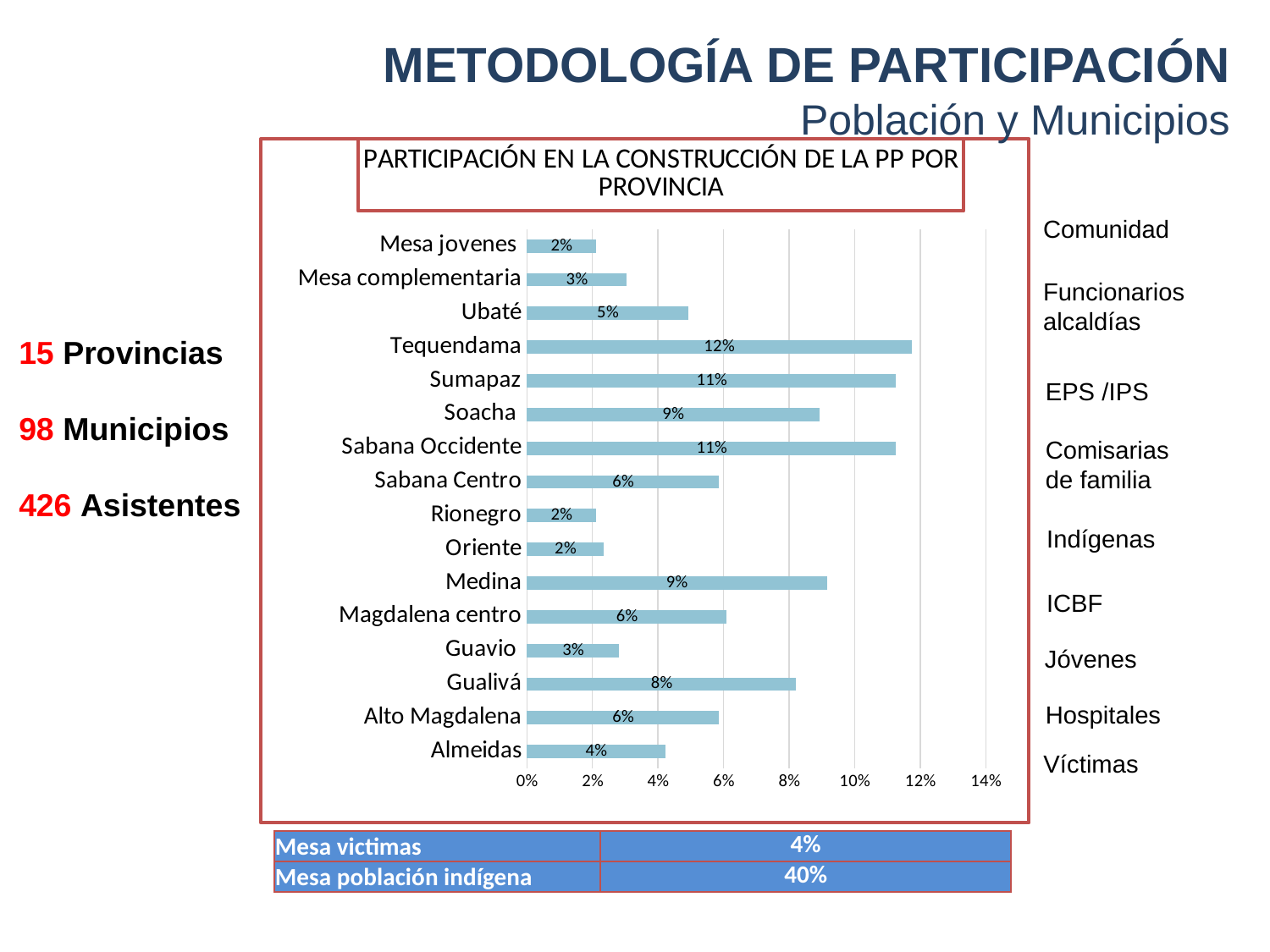
What is the difference between the values for Tequendama and Almeidas? 8% What kind of chart is shown on the slide? bar chart What is the value for Tequendama? 12% What is the value for Sabana Occidente? 11% How many categories are plotted in the chart? 16 What is the title of the chart? PARTICIPACIÓN EN LA CONSTRUCCIÓN DE LA PP POR PROVINCIA What is the value for Gualivá? 8% Which is larger, the value for Gualivá or the value for Ubaté? Gualivá Is the value for Sumapaz greater or less than 10%? greater Is the value for Guavio greater or less than 4%? less Which category has the highest value? Tequendama What is the value for Almeidas? 4%